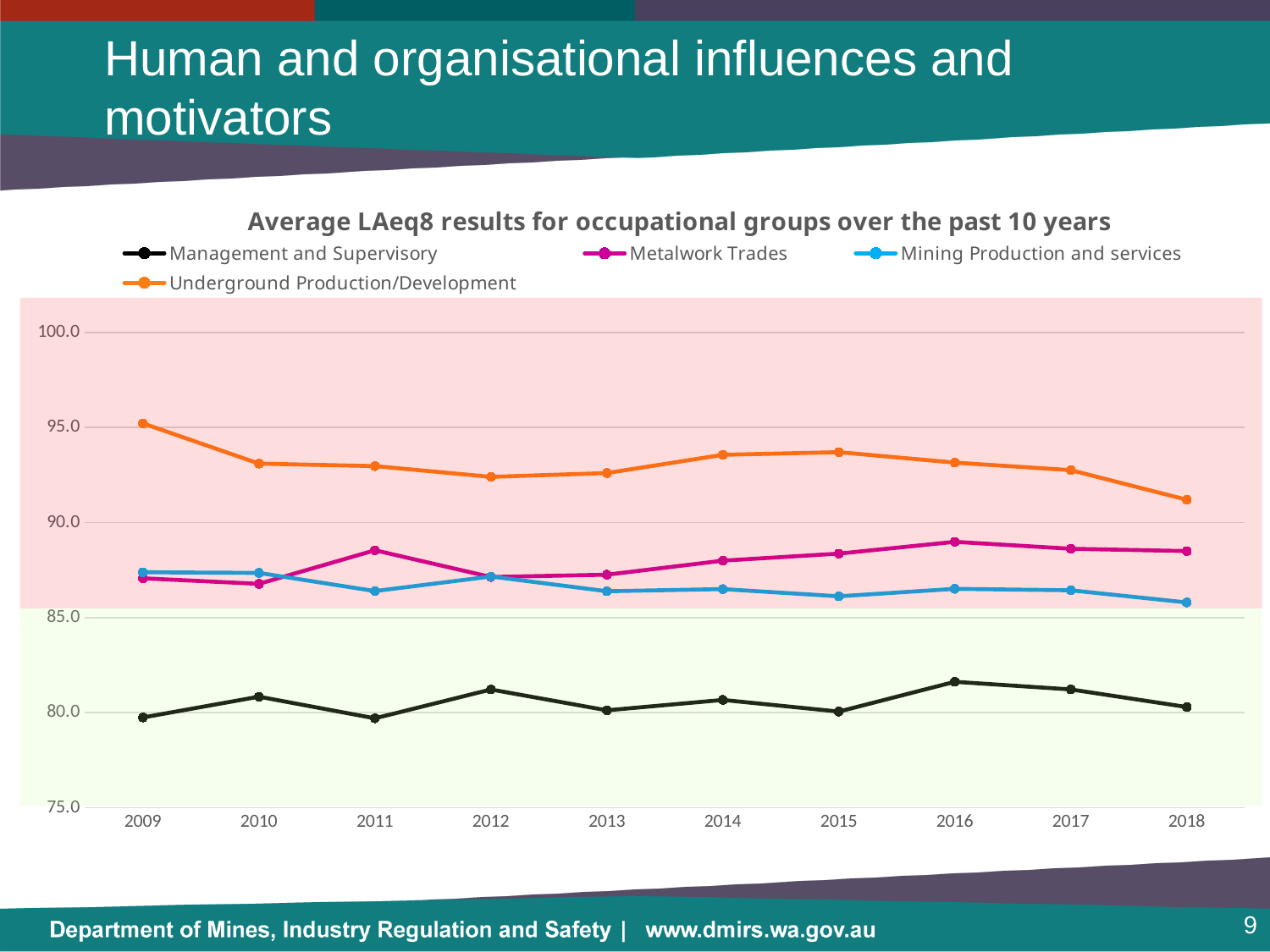
What is the title of the chart? Average LAeq8 results for occupational groups over the past 10 years Is the value for Metalwork Trades in 2016 greater or less than 90.0? less In 2011, which is higher: Metalwork Trades or Mining Production and services? Metalwork Trades How many series does the legend list? 4 Which occupational group has the highest values across the chart? Underground Production/Development How many years are shown along the x axis? 10 Does the Underground Production/Development line rise or fall overall from 2009 to 2018? fall Is the value for Management and Supervisory in 2016 greater or less than 80.0? greater Which occupational group has the lowest values across the chart? Management and Supervisory In which year is the Underground Production/Development value highest? 2009 Is the value for Underground Production/Development in 2018 greater or less than 90.0? greater What kind of chart is shown on the slide? line chart